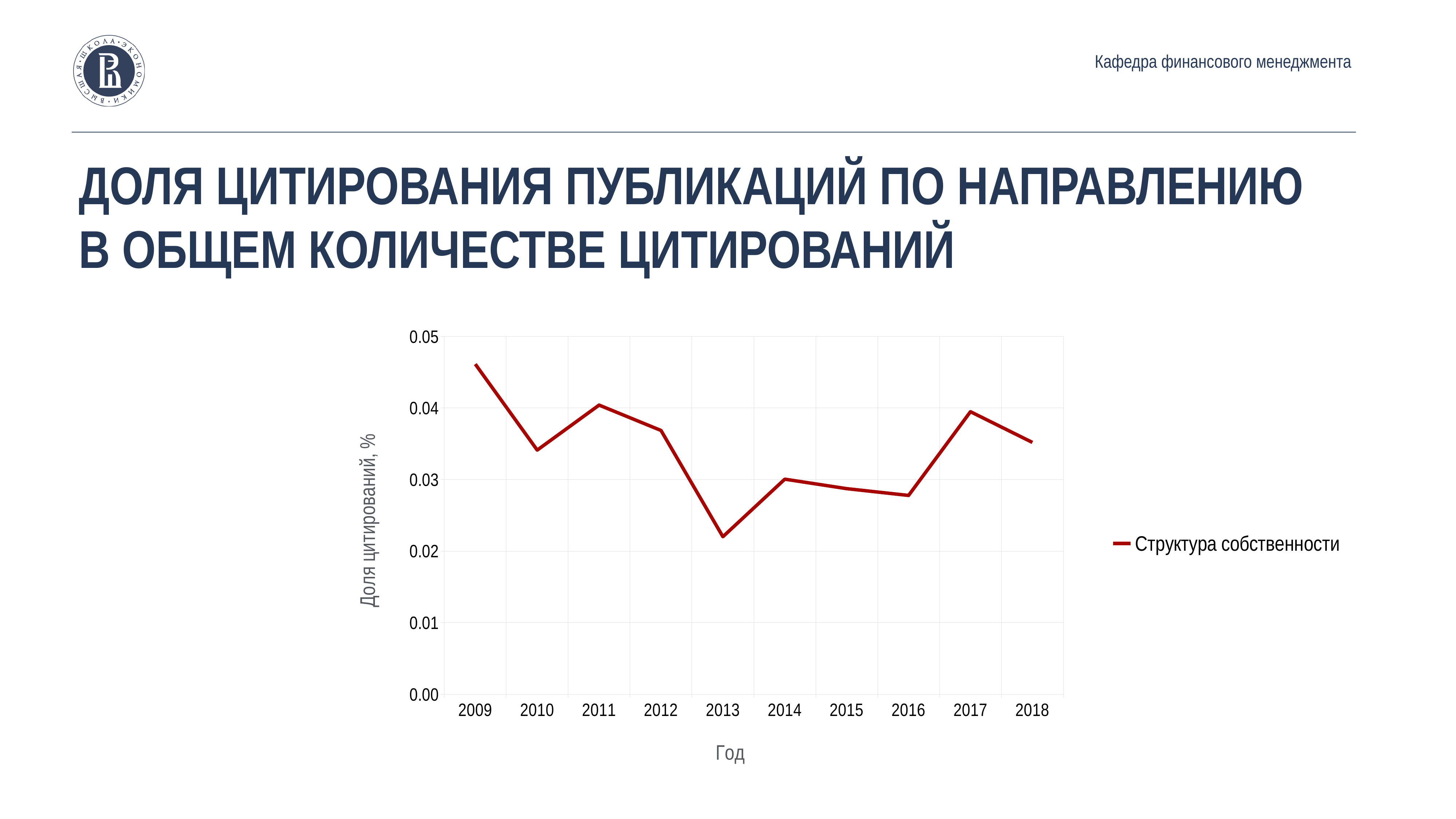
Which year has the larger value, 2017 or 2016? 2017 Which year has the lowest value on the chart? 2013 Which year has the larger value, 2009 or 2013? 2009 Does the value rise or fall from 2012 to 2013? fall How many series does the chart legend list? 1 Is the value for 2016 greater or less than 0.03? less Is the value for 2009 greater or less than 0.04? greater What is the name of the series shown in the chart legend? Структура собственности What kind of chart is shown on the slide? Line chart Which year has the highest value on the chart? 2009 Is the value for 2013 greater or less than 0.03? less How many years are plotted along the x axis of the chart? 10